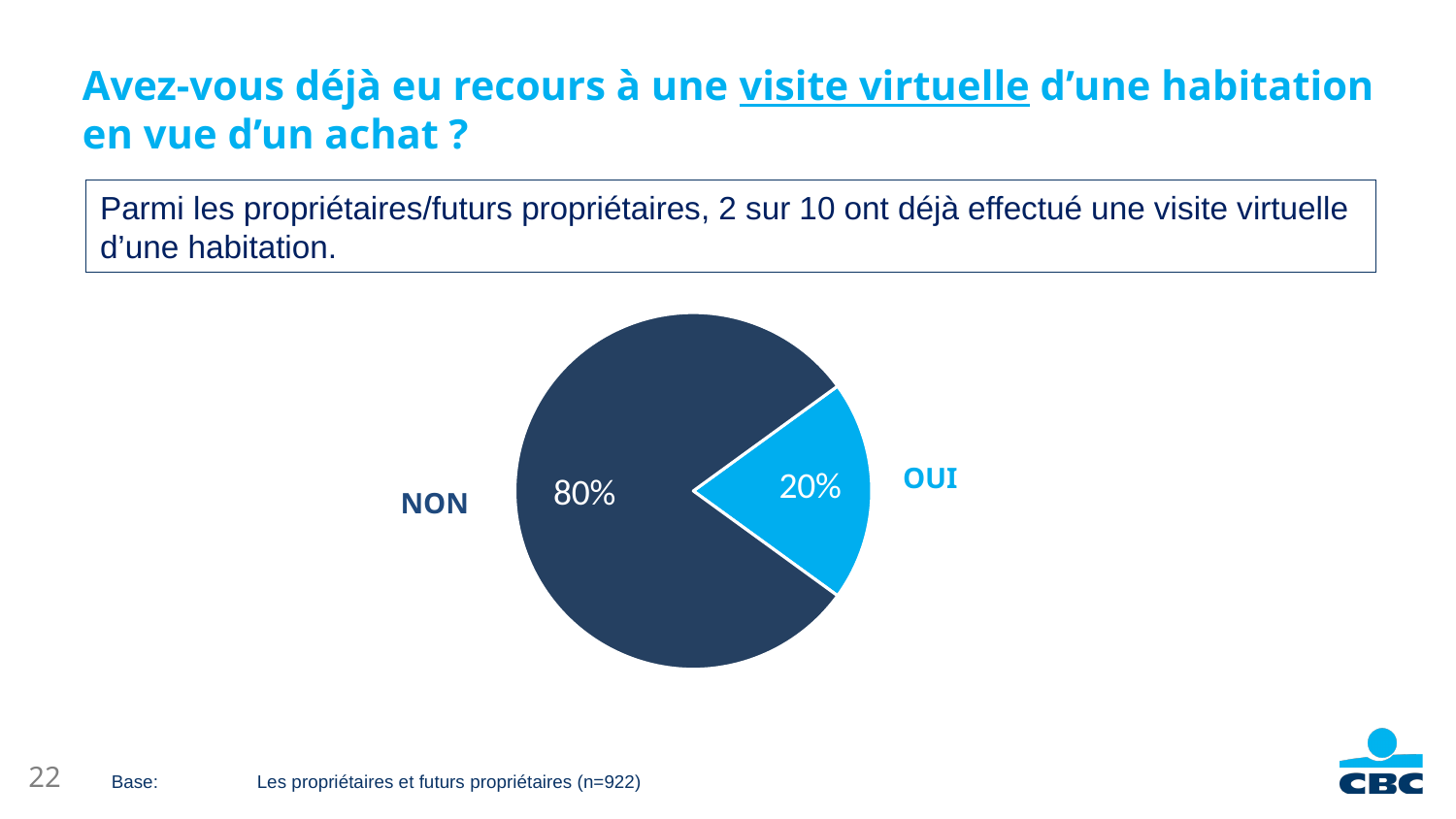
What is the sample size (n) given in the base note below the chart? 922 How many slices does the pie chart have? 2 What percentage of respondents answered NON? 80% What colour is the OUI slice? light blue What kind of chart is shown on the slide? pie chart What share of the pie does the OUI slice represent? 20% What percentage of respondents answered OUI? 20% Which is larger, the share for OUI or the share for NON? NON Which category has the largest share of the pie? NON Which category has the smallest share of the pie? OUI What is the difference in percentage points between NON and OUI? 60